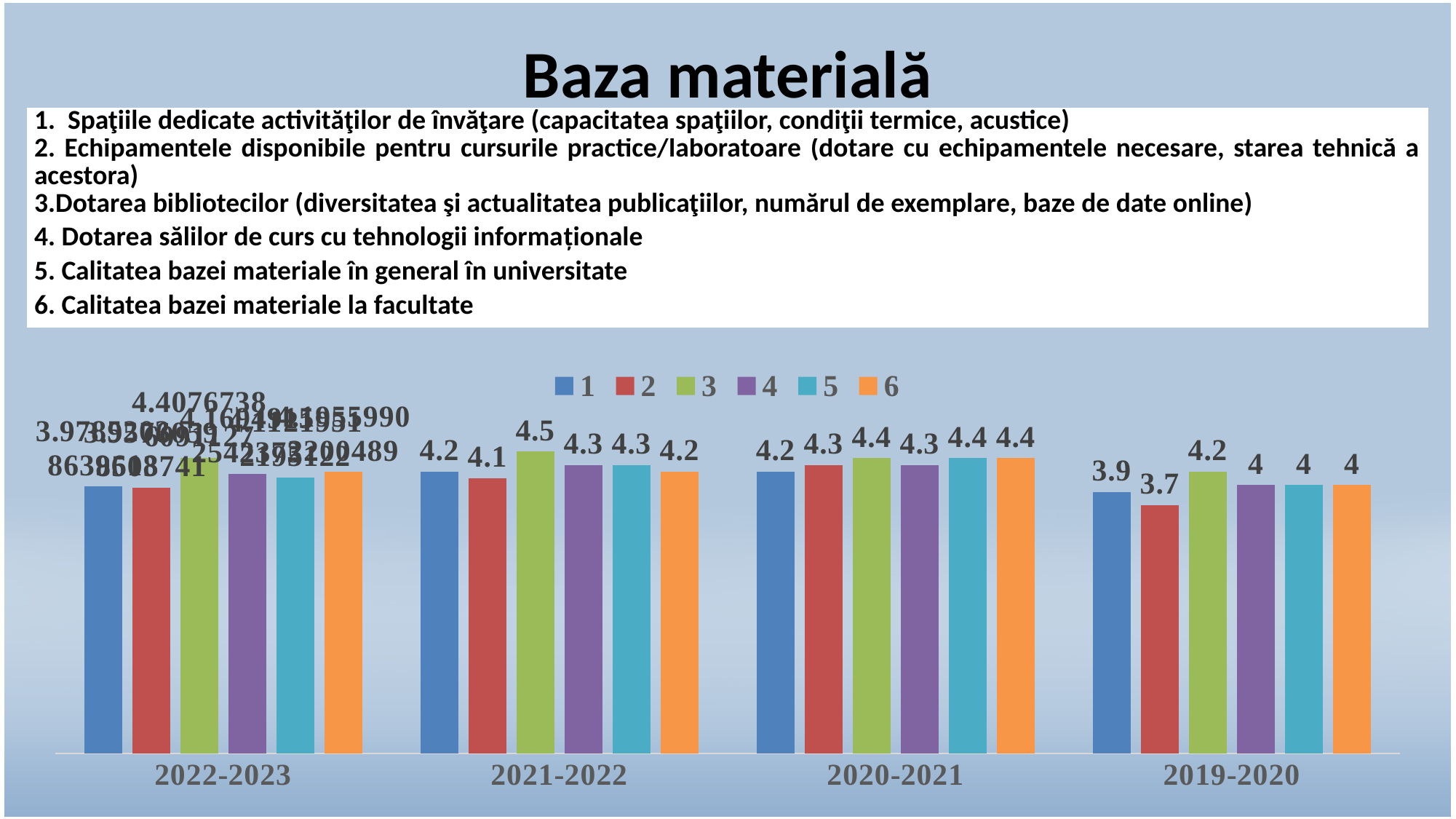
What is the title of the slide containing the chart? Baza materială What type of chart is shown on the slide? bar chart What is the value for series 1 in 2020-2021? 4.2 What is the value for series 3 in 2021-2022? 4.5 How many series does the legend list? 6 Which series has the lowest value in 2019-2020? 2 What is the difference between series 3 and series 2 in 2021-2022? 0.4 What is the value for series 6 in 2019-2020? 4 How many academic-year categories are shown on the x axis? 4 Which series has the highest value in 2021-2022? 3 What is the value for series 2 in 2019-2020? 3.7 Which is larger in 2019-2020: series 1 or series 3? series 3